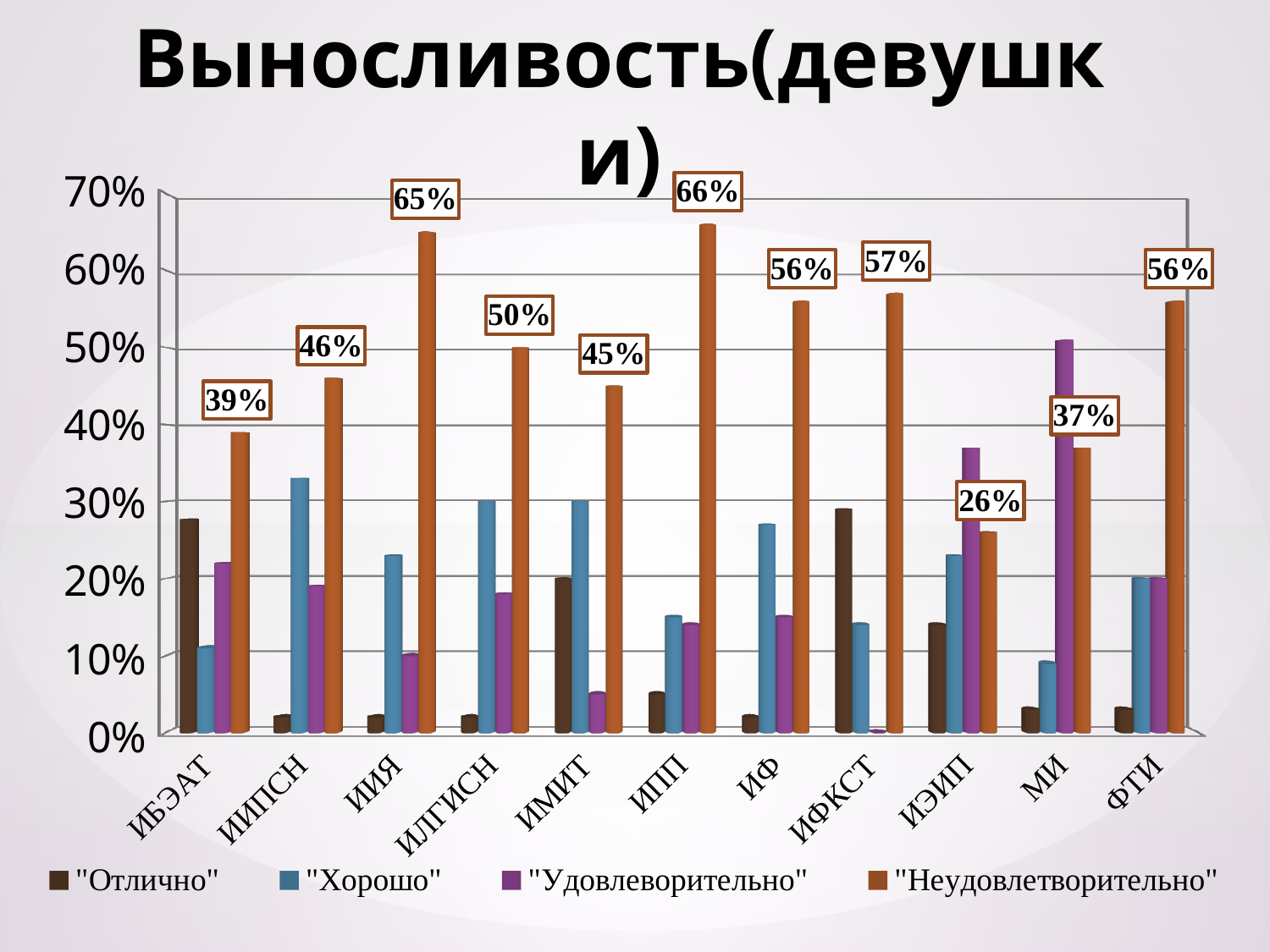
Which category has the lowest "Неудовлетворительно" value? ИЭИП Which is larger: the "Неудовлетворительно" value for ИИПСН or for ИЛГИСН? ИЛГИСН Is the "Хорошо" value for ИИПСН greater or less than 30%? greater How many categories are shown on the x axis? 11 What type of chart is shown on the slide? Bar chart What is the value of the "Неудовлетворительно" series for ИЭИП? 26% Which category has the highest "Неудовлетворительно" value? ИПП How many series does the legend list? 4 What is the value of the "Неудовлетворительно" series for ИПП? 66% Is the "Удовлеворительно" value for МИ greater or less than 40%? greater What is the value of the "Неудовлетворительно" series for ИИЯ? 65% What is the difference between the "Неудовлетворительно" values for ИПП and ИЭИП? 40 percentage points